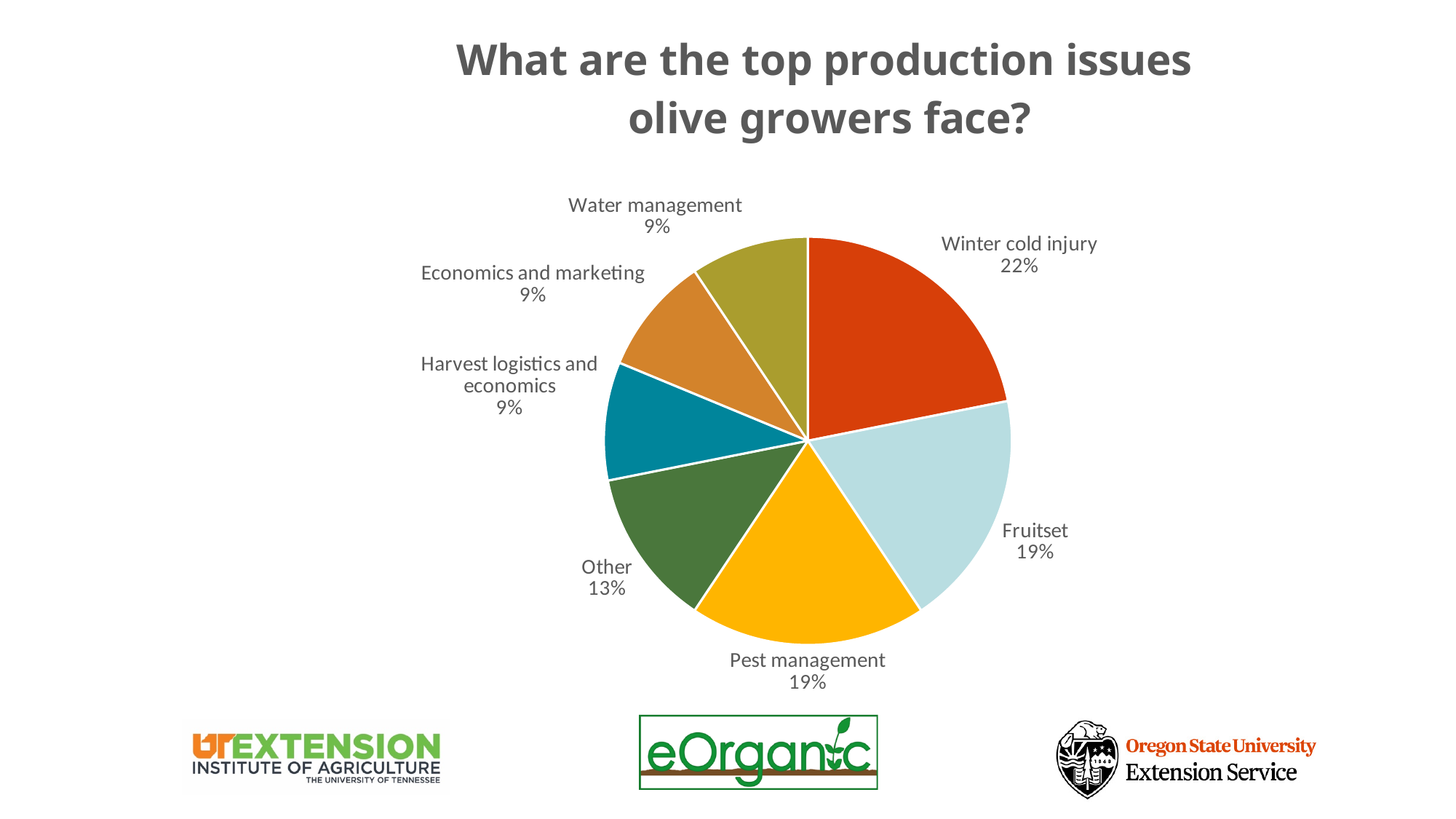
How many slices does the pie chart have? 7 What is the difference in percentage points between Winter cold injury and Other? 9 Which is larger, the slice for Fruitset or the slice for Other? Fruitset What percentage is shown for Pest management? 19% Which category has the largest slice of the pie? Winter cold injury What percentage is shown for Water management? 9% What share of the pie does Winter cold injury represent? 22% What is the title of the chart? What are the top production issues olive growers face? What colour is the Pest management slice? Yellow What is the difference in percentage points between Fruitset and Harvest logistics and economics? 10 What percentage is shown for Other? 13% What kind of chart is shown on the slide? Pie chart